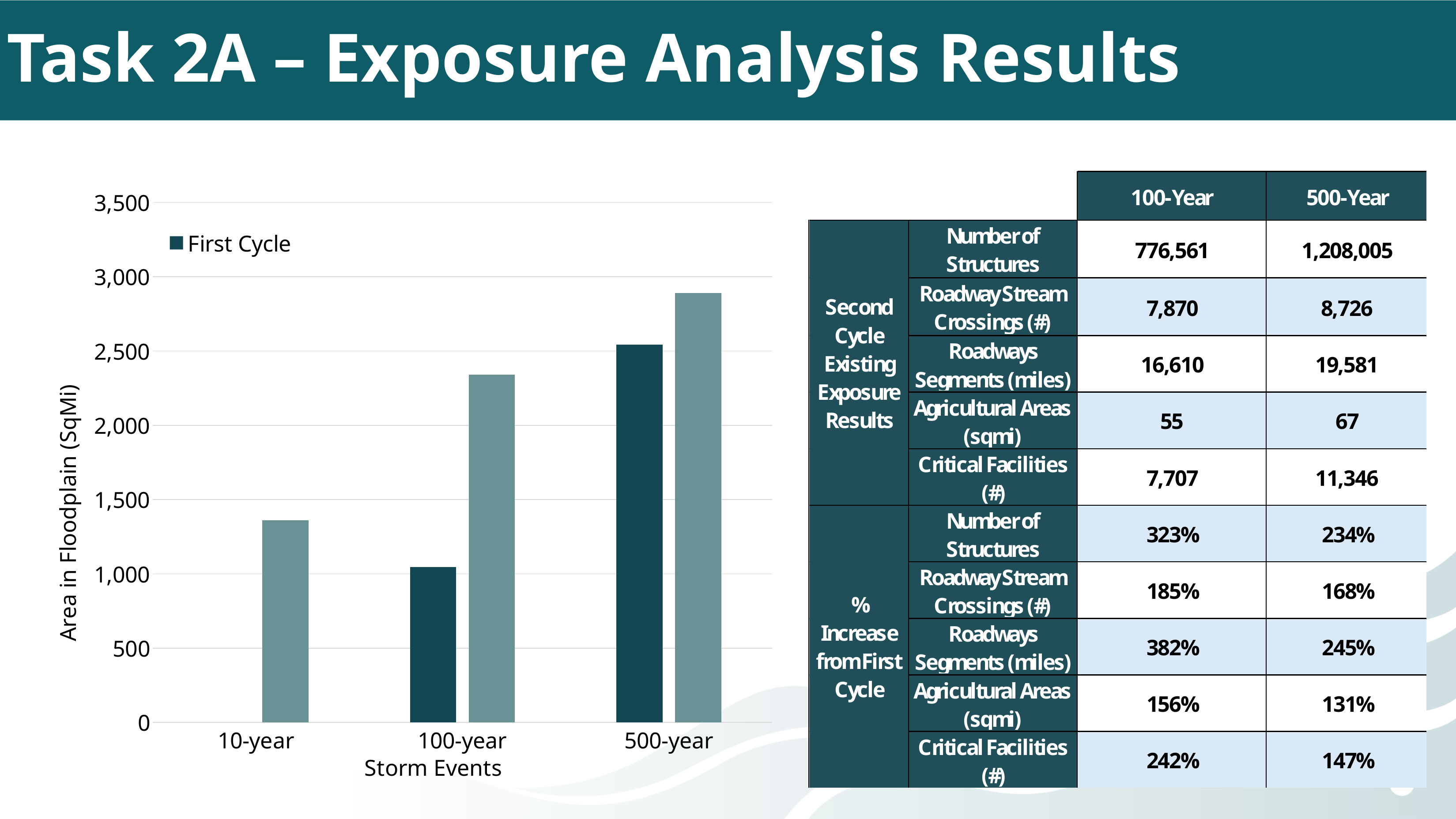
What kind of chart is shown on the left of the slide? bar chart Is the value of the lighter bar for 500-year greater or less than 2,500? greater What is the title of the vertical axis of the bar chart? Area in Floodplain (SqMi) What is the only series name shown in the legend of the bar chart? First Cycle How many series does the legend of the bar chart list? 1 Which is larger in the chart: the lighter bar for 10-year or the lighter bar for 100-year? 100-year Among the lighter bars in the chart, which storm event category has the lowest value? 10-year Which storm event category has the tallest bar in the chart? 500-year How many storm event categories are shown on the x axis of the bar chart? 3 Is the value of the lighter bar for 10-year greater or less than 1,000? greater Is the value of the darker bar for 100-year greater or less than 1,500? less Do the lighter bars rise or fall moving from 10-year to 500-year along the x axis? rise